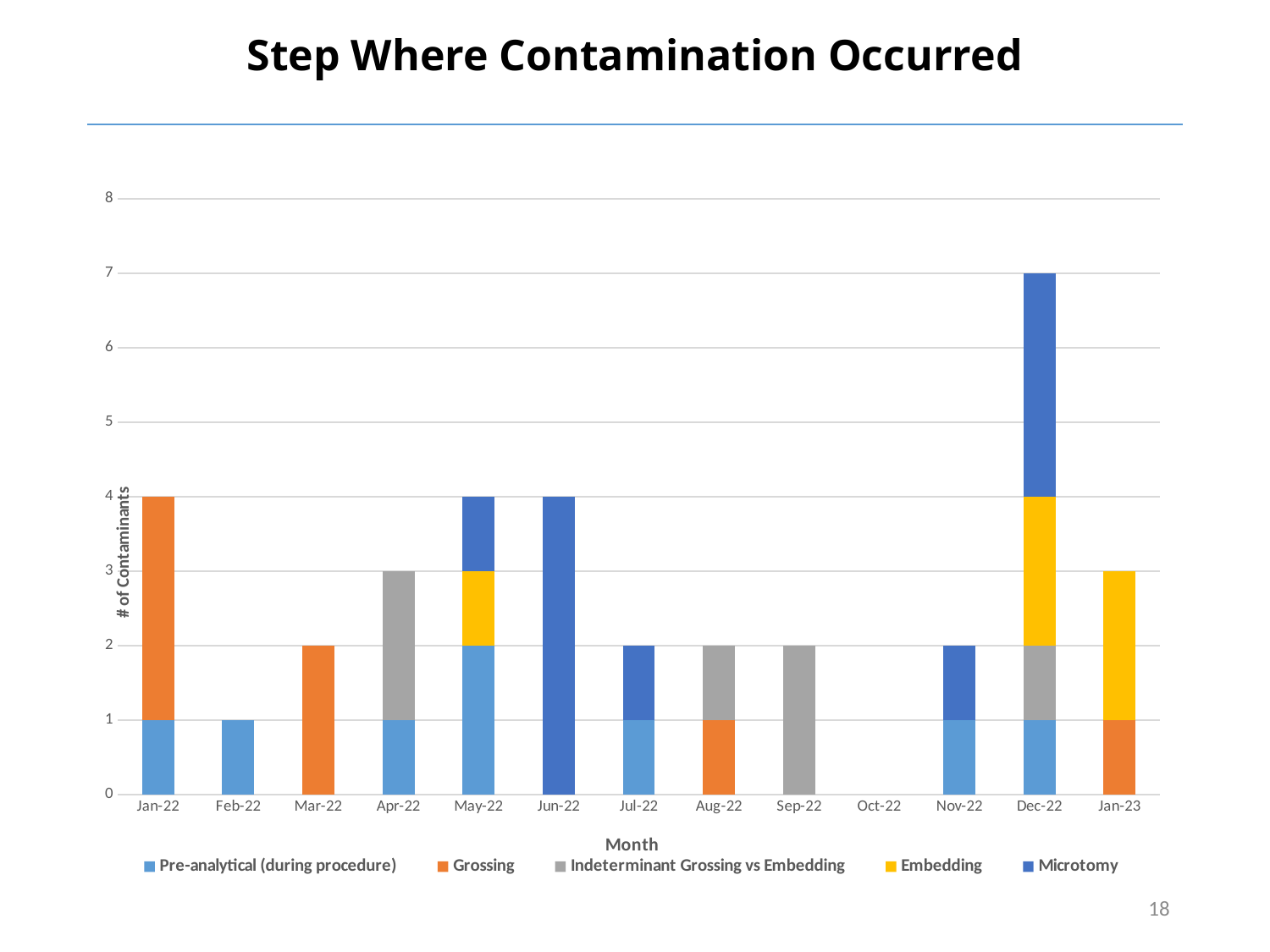
How many contaminants are attributed to Microtomy in Jun-22? 4 How many months are shown on the x axis? 13 What is the total number of contaminants for Dec-22? 7 Which month has no contaminants recorded at all? Oct-22 What is the difference between the total contaminants in Dec-22 and Jan-23? 4 Which month has the highest total number of contaminants? Dec-22 What kind of chart is shown on the slide? Stacked bar chart Which month has a larger total number of contaminants, Apr-22 or Feb-22? Apr-22 What is the total number of contaminants for Jan-22? 4 What is the title of the chart? Step Where Contamination Occurred How many series does the legend list? 5 Is the total number of contaminants for Dec-22 greater or less than 5? greater